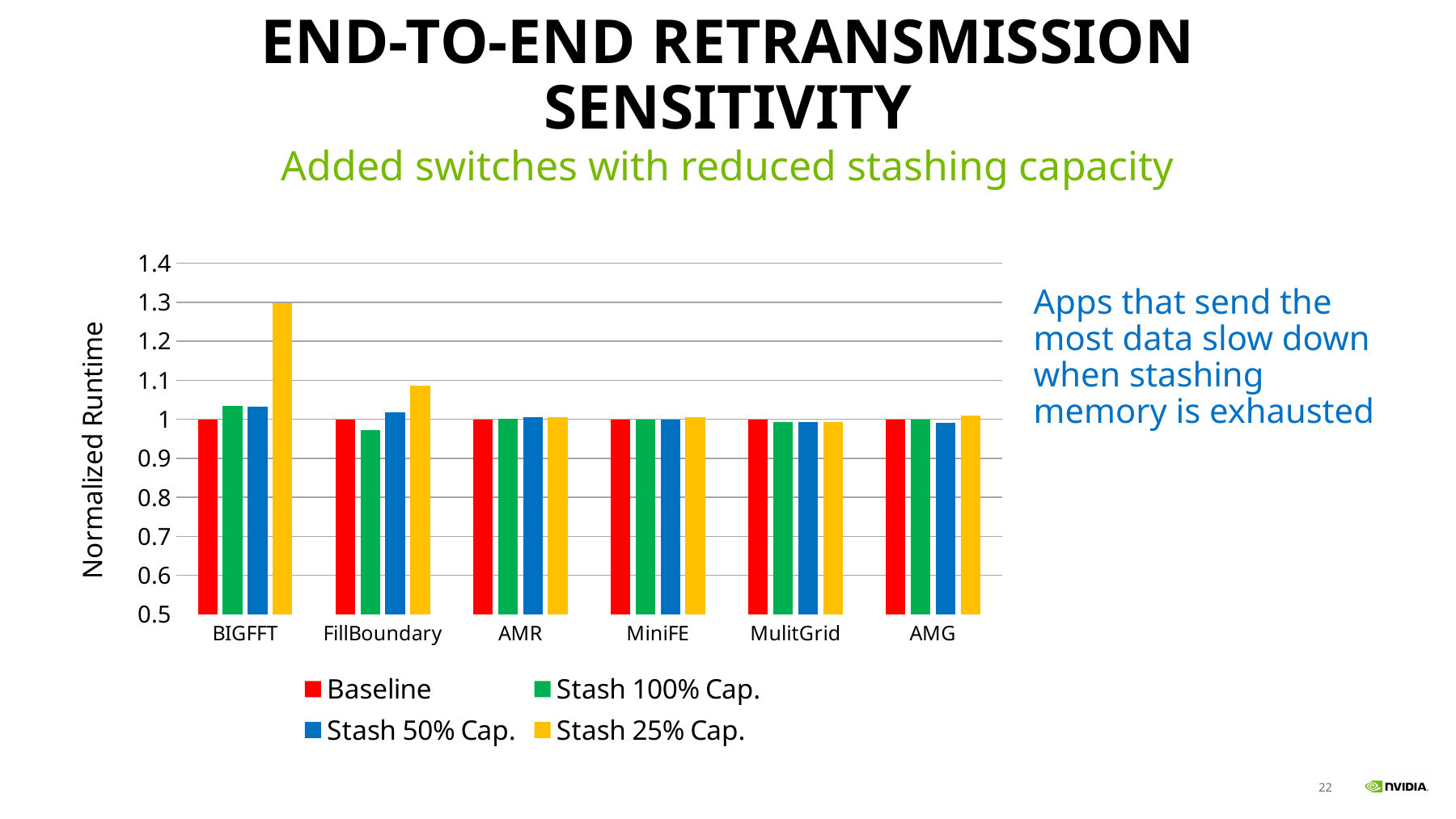
What colour represents the Stash 25% Cap. series? yellow Is the Stash 100% Cap. value for FillBoundary greater or less than 1? less What is the label on the y axis? Normalized Runtime What is the Baseline value for BIGFFT? 1 Which application has the lowest Stash 100% Cap. bar? FillBoundary Which application has the highest Stash 25% Cap. bar? BIGFFT How many application categories are shown on the x axis? 6 Is the Stash 25% Cap. value for BIGFFT greater or less than 1.2? greater What kind of chart is shown on the slide? bar chart Which is larger: the Stash 25% Cap. value for BIGFFT or for FillBoundary? BIGFFT Is the Stash 25% Cap. value for FillBoundary greater or less than 1? greater How many series does the legend list? 4